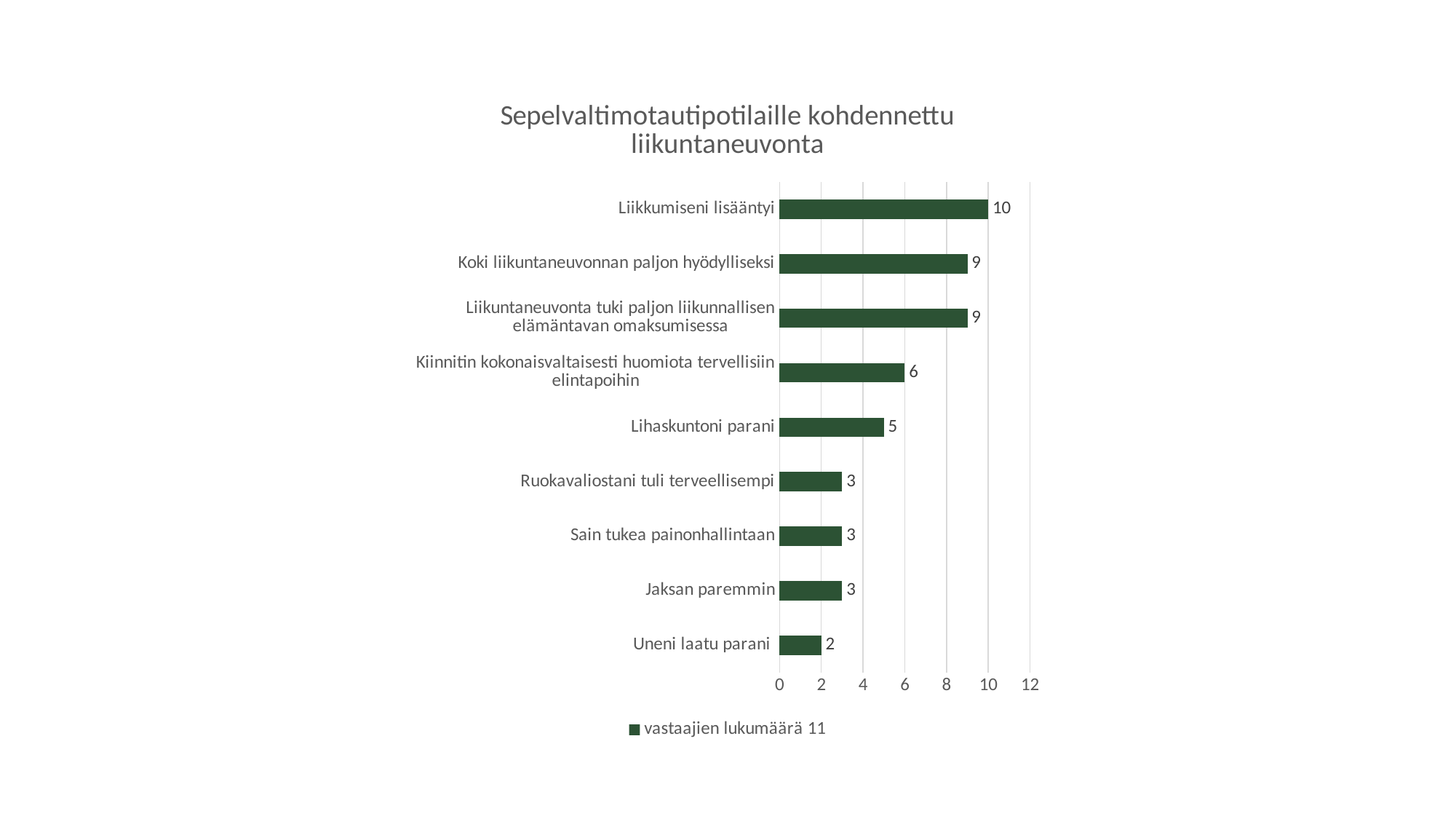
What is the value for "Kiinnitin kokonaisvaltaisesti huomiota tervellisiin elintapoihin"? 6 What is the difference between the values for "Liikkumiseni lisääntyi" and "Lihaskuntoni parani"? 5 What is the value for "Lihaskuntoni parani"? 5 Which category has the highest value? Liikkumiseni lisääntyi What is the value for "Uneni laatu parani"? 2 What is the legend entry of the chart? vastaajien lukumäärä 11 What is the value for "Liikkumiseni lisääntyi"? 10 Which category has the lowest value? Uneni laatu parani Which is larger, the value for "Koki liikuntaneuvonnan paljon hyödylliseksi" or the value for "Ruokavaliostani tuli terveellisempi"? Koki liikuntaneuvonnan paljon hyödylliseksi How many series does the legend list? 1 What kind of chart is shown on the slide? Bar chart How many categories are shown in the chart? 9